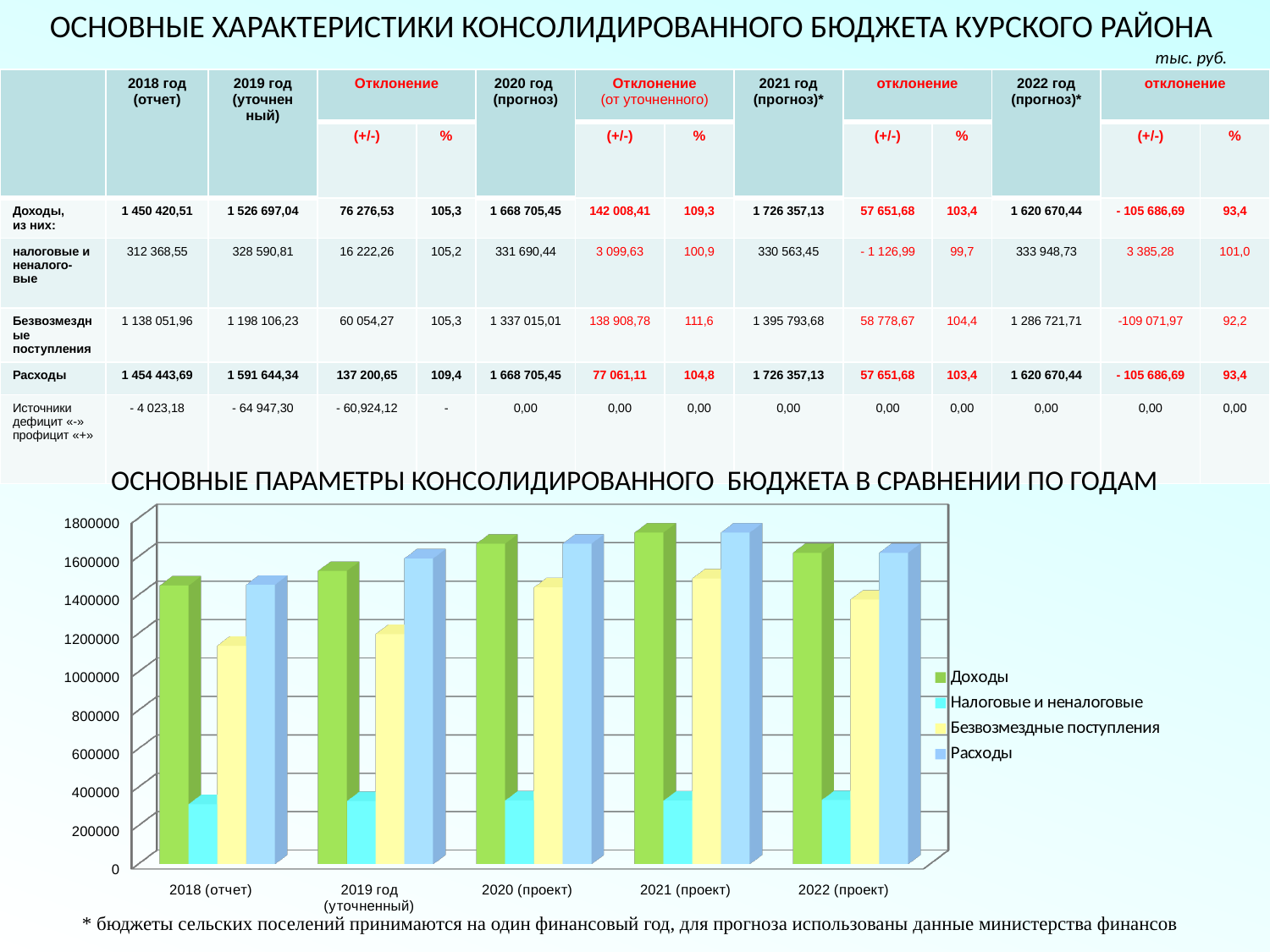
How many series does the legend of the bar chart list? 4 In the bar chart, do the values of Доходы rise or fall from 2018 (отчет) to 2021 (проект)? rise In the bar chart, is the value of Безвозмездные поступления for 2018 (отчет) greater or less than 1000000? greater In the bar chart, is the value of Доходы for 2018 (отчет) greater or less than 1400000? greater In the bar chart, for 2018 (отчет), which is larger: Доходы or Безвозмездные поступления? Доходы In the bar chart, which year has the highest value for Доходы? 2021 (проект) In the bar chart, which series is shown in green? Доходы In the bar chart, for 2019 год (уточненный), which is larger: Доходы or Расходы? Расходы In the bar chart, is the value of Налоговые и неналоговые for 2018 (отчет) greater or less than 400000? less How many year categories are shown along the x axis of the bar chart? 5 What kind of chart is shown under the heading 'ОСНОВНЫЕ ПАРАМЕТРЫ КОНСОЛИДИРОВАННОГО БЮДЖЕТА В СРАВНЕНИИ ПО ГОДАМ'? Bar chart